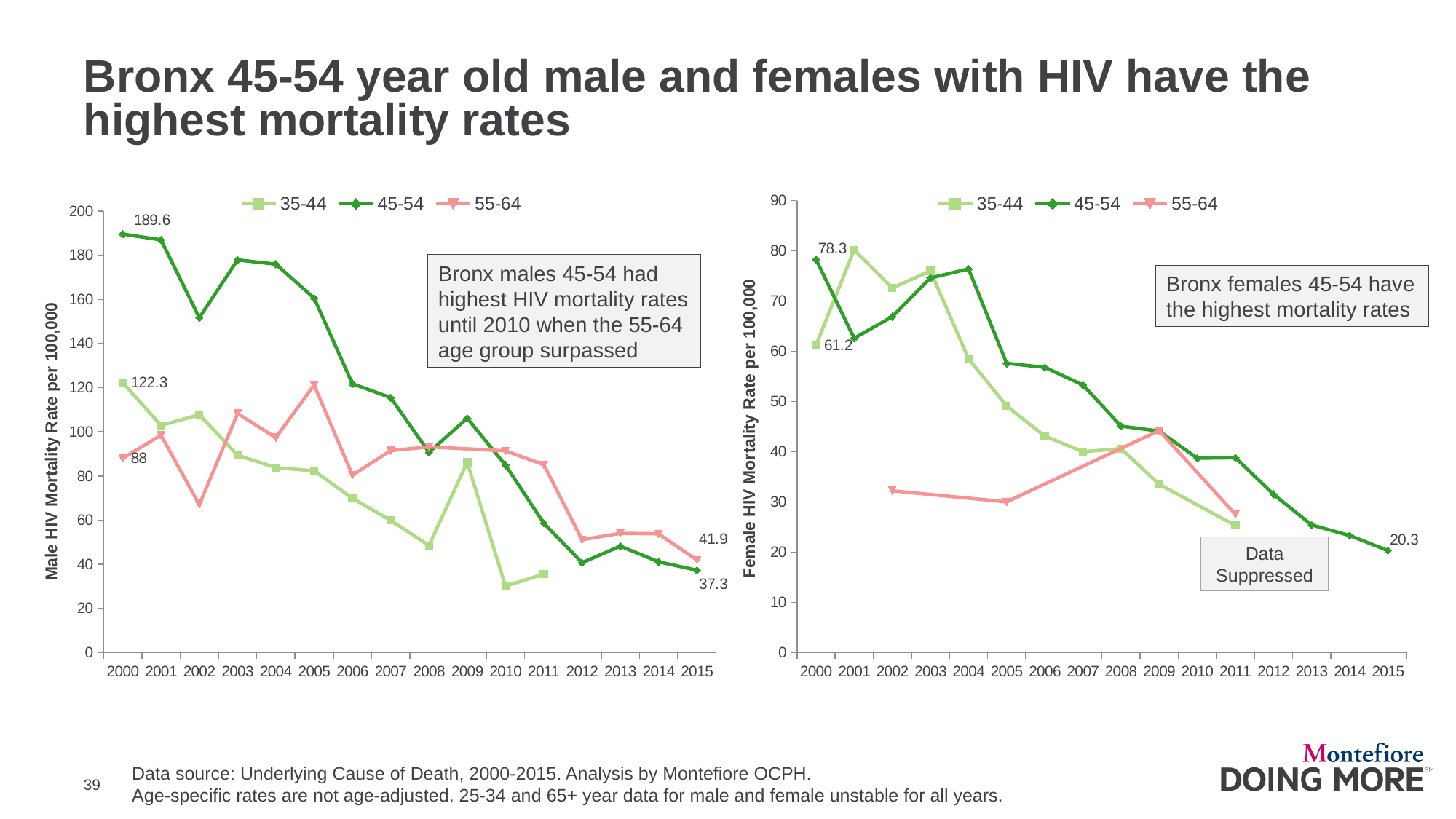
In the left chart (male), what is the difference between the 45-54 and 35-44 rates in 2000? 67.3 What is the y-axis title of the left chart? Male HIV Mortality Rate per 100,000 In the left chart (male), what is the HIV mortality rate for the 35-44 age group in 2000? 122.3 In the left chart (male), which age group had the higher rate in 2015, 45-54 or 55-64? 55-64 What kind of chart is the right chart? Line chart In the right chart (female), does the 45-54 series generally rise or fall from 2004 to 2015? Fall In the right chart (female), is the value for the 45-54 age group in 2004 greater or less than 70? greater In the right chart (female), what is the HIV mortality rate for the 45-54 age group in 2015? 20.3 In the left chart (male), what is the HIV mortality rate for the 45-54 age group in 2000? 189.6 In the right chart (female), what is the difference between the 45-54 and 35-44 rates in 2000? 17.1 In the left chart (male), what is the HIV mortality rate for the 55-64 age group in 2015? 41.9 How many series does the legend of the left chart list? 3